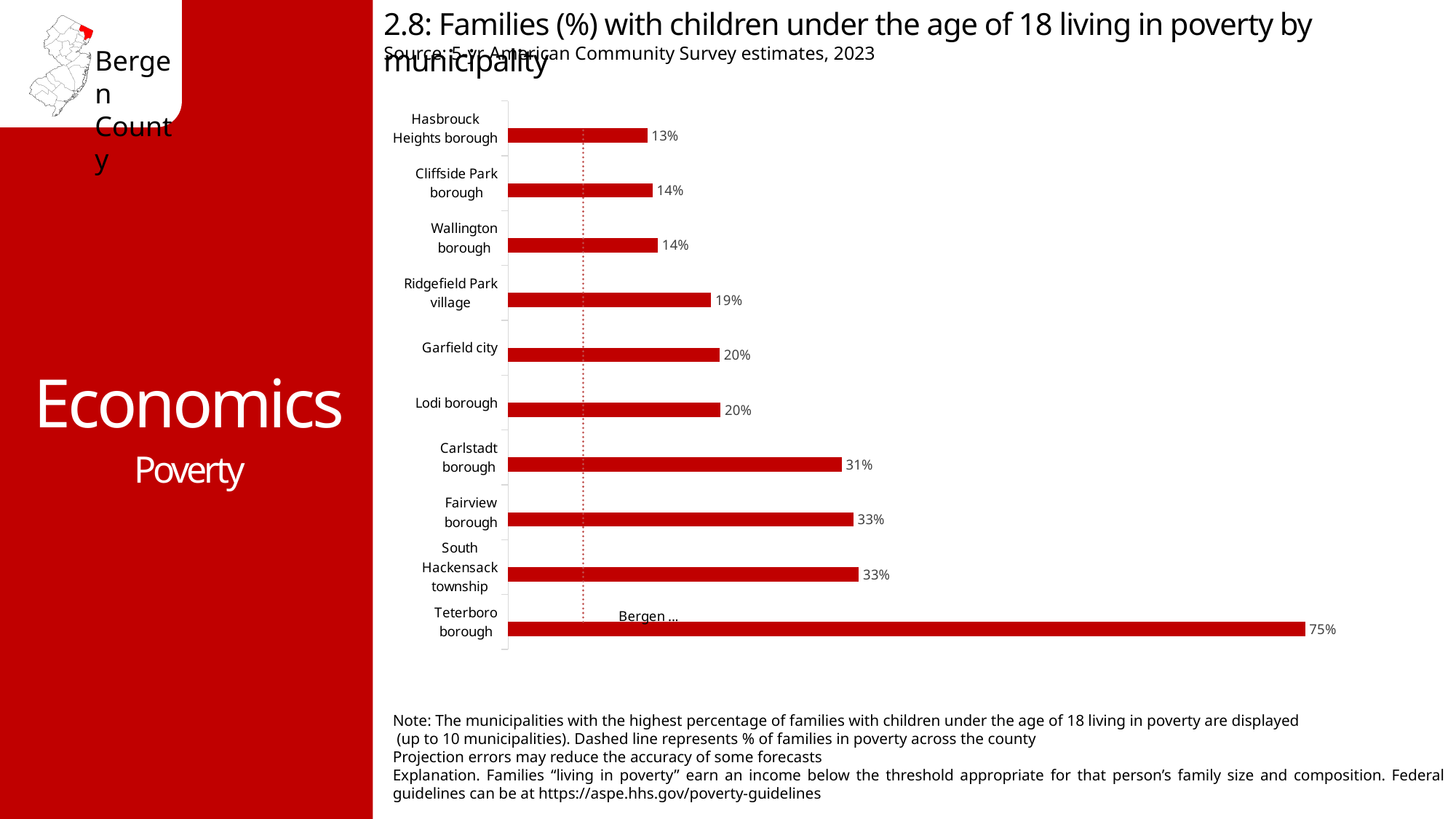
According to the note, what does the dashed line on the chart represent? % of families in poverty across the county What percentage of families with children under 18 are living in poverty in Teterboro borough? 75% What is the value shown for Garfield city? 20% What is the value shown for Ridgefield Park village? 19% How many municipalities are shown on the chart? 10 What type of chart is used on this slide? Bar chart What is the difference between the values for Teterboro borough and South Hackensack township? 42% Which has a higher value, Fairview borough or Wallington borough? Fairview borough Which municipality has the highest percentage of families with children living in poverty? Teterboro borough What is the difference between the values for Carlstadt borough and Lodi borough? 11% Which municipality has the lowest percentage shown on the chart? Hasbrouck Heights borough What is the value shown for Carlstadt borough? 31%